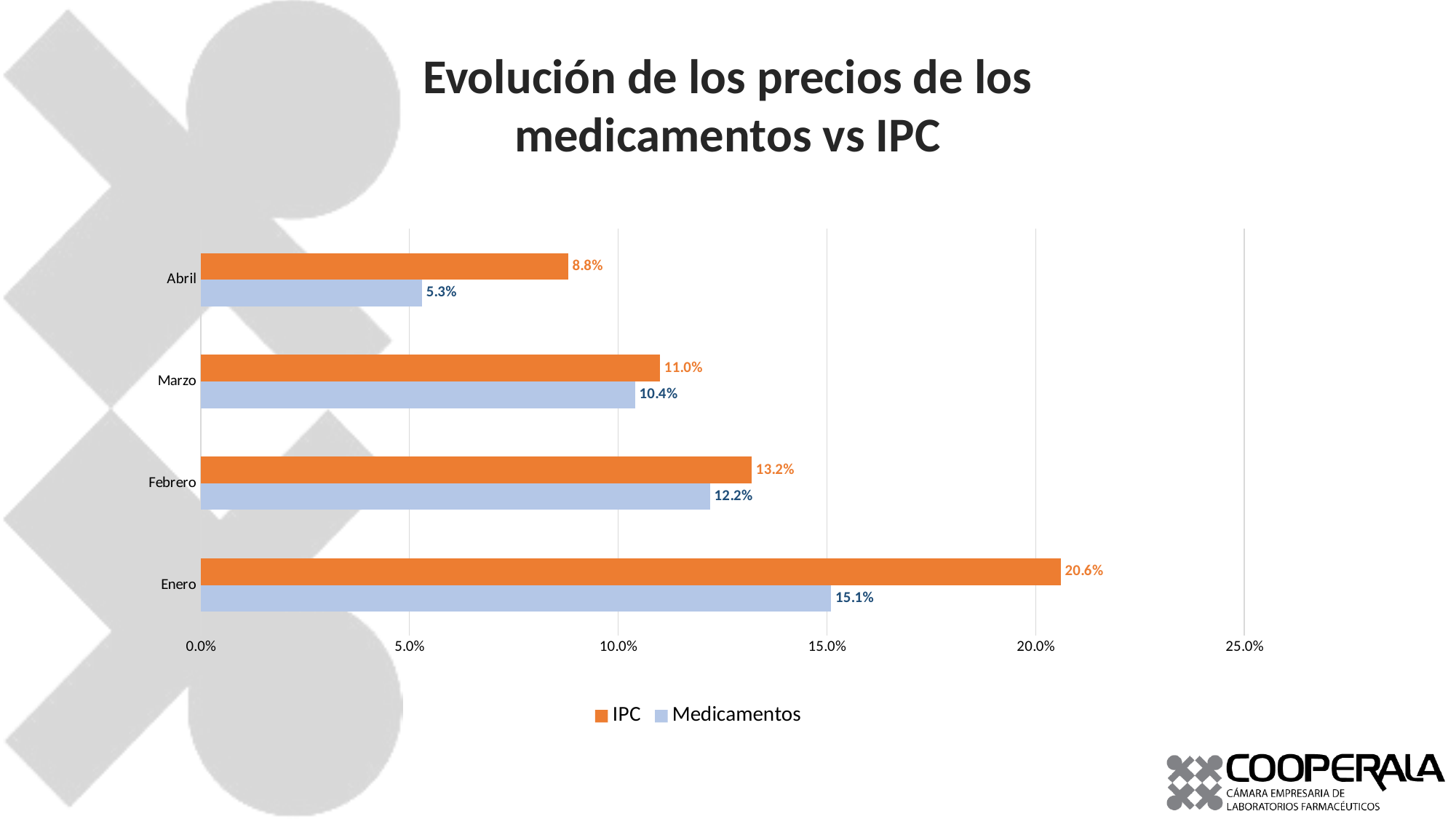
What kind of chart is shown on the slide? Bar chart What is the difference between the IPC and Medicamentos values for Enero? 5.5% How many series does the legend list? 2 What is the IPC value for Enero? 20.6% What is the title of the chart? Evolución de los precios de los medicamentos vs IPC Which month has the highest IPC value? Enero What is the difference between the IPC values for Febrero and Marzo? 2.2% Which is larger for Abril, the IPC value or the Medicamentos value? IPC Which month has the lowest Medicamentos value? Abril How many months are shown on the chart? 4 What is the Medicamentos value for Marzo? 10.4% What is the Medicamentos value for Abril? 5.3%